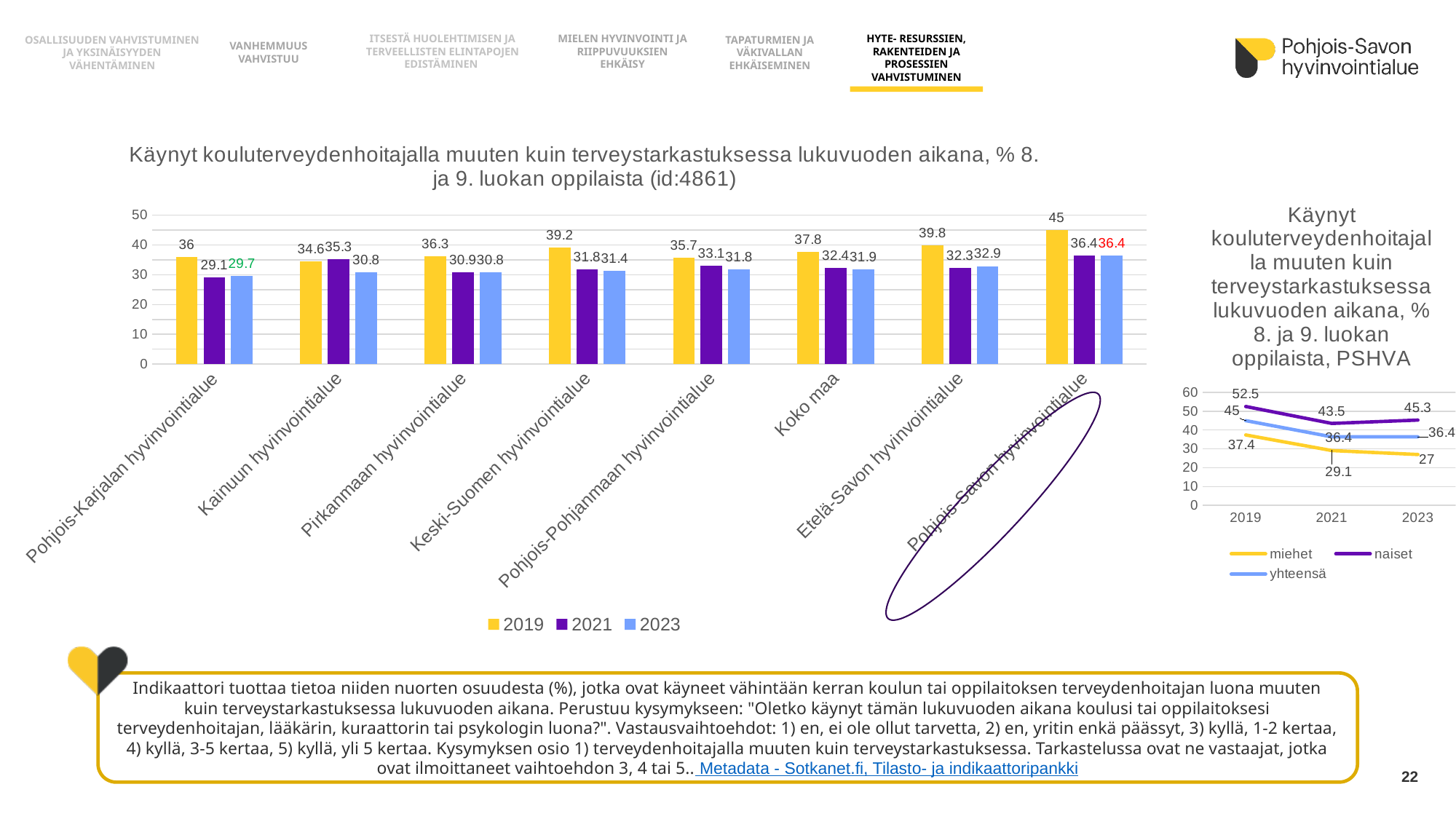
In the bar chart on the left, what is the 2019 value for Pohjois-Savon hyvinvointialue? 45 In the bar chart on the left, which category has the lowest 2021 value? Pohjois-Karjalan hyvinvointialue In the line chart on the right, what is the value for naiset in 2019? 52.5 In the bar chart on the left, what is the difference between the 2019 and 2021 values for Keski-Suomen hyvinvointialue? 7.4 In the bar chart on the left, which is larger for Kainuun hyvinvointialue: the 2019 value or the 2021 value? 2021 In the line chart on the right, what is the difference between naiset and miehet in 2023? 18.3 How many categories are shown on the x axis of the bar chart on the left? 8 In the bar chart on the left, which category has the highest 2019 value? Pohjois-Savon hyvinvointialue In the line chart on the right, does the miehet series rise or fall from 2019 to 2023? fall How many series does the legend of the bar chart on the left list? 3 What kind of chart is the chart on the left? bar chart In the bar chart on the left, what is the 2023 value for Koko maa? 31.9